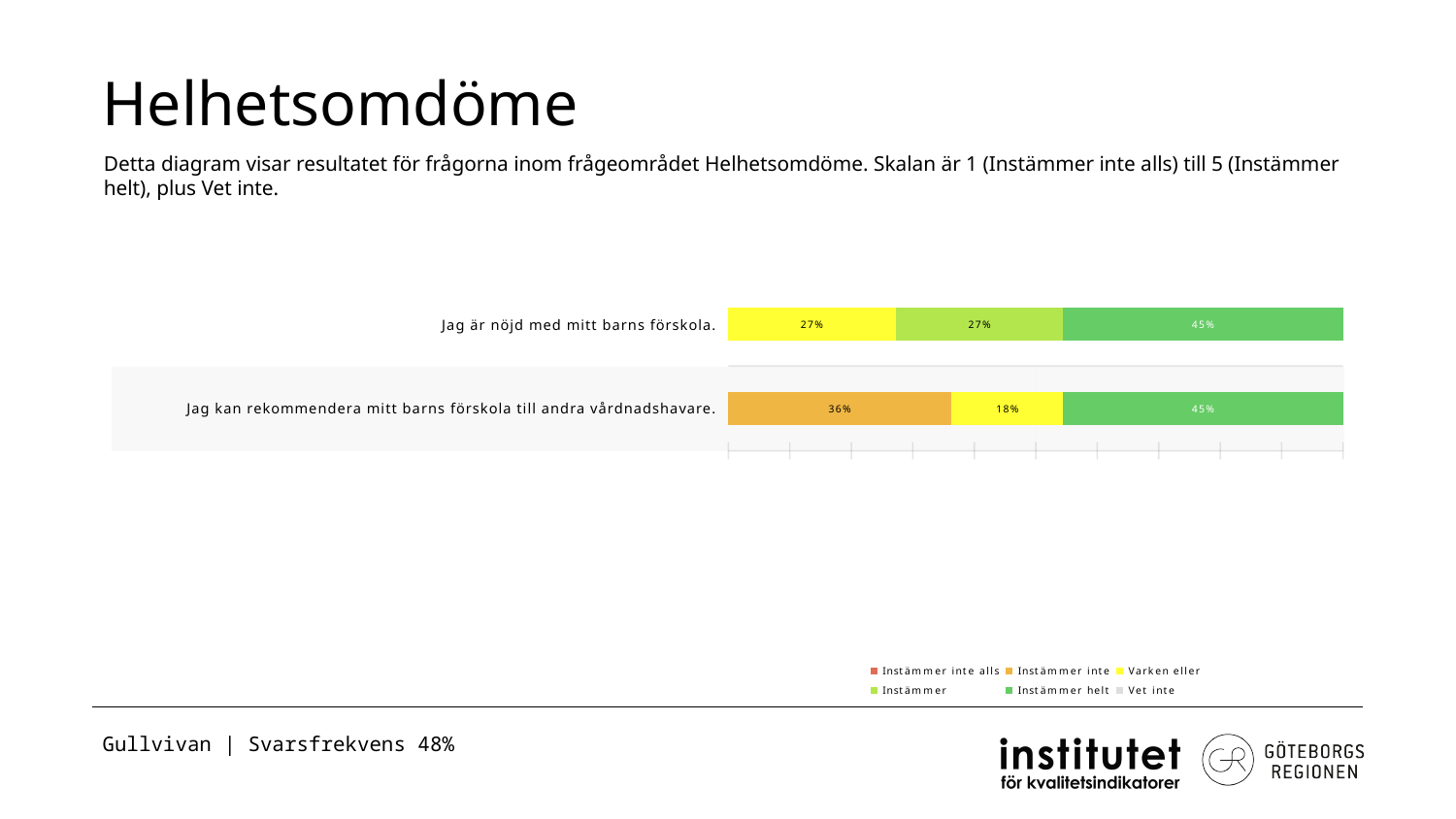
What kind of chart is shown on the slide? stacked bar chart Which segment is the largest in the bar for 'Jag är nöjd med mitt barns förskola.'? Instämmer helt What is the 'Instämmer inte' value for 'Jag kan rekommendera mitt barns förskola till andra vårdnadshavare.'? 36% What is the difference between the 'Varken eller' values for 'Jag är nöjd med mitt barns förskola.' and 'Jag kan rekommendera mitt barns förskola till andra vårdnadshavare.'? 9% How many series does the legend list? 6 What is the 'Instämmer helt' value for 'Jag är nöjd med mitt barns förskola.'? 45% What colour represents 'Instämmer helt' in the legend? green How many categories (questions) are plotted in the chart? 2 What is the 'Instämmer' value for 'Jag är nöjd med mitt barns förskola.'? 27% What is the 'Varken eller' value for 'Jag kan rekommendera mitt barns förskola till andra vårdnadshavare.'? 18% What is the total of the labelled segments in the bar for 'Jag kan rekommendera mitt barns förskola till andra vårdnadshavare.'? 99% Which is larger for 'Jag kan rekommendera mitt barns förskola till andra vårdnadshavare.': the 'Instämmer inte' value or the 'Varken eller' value? Instämmer inte